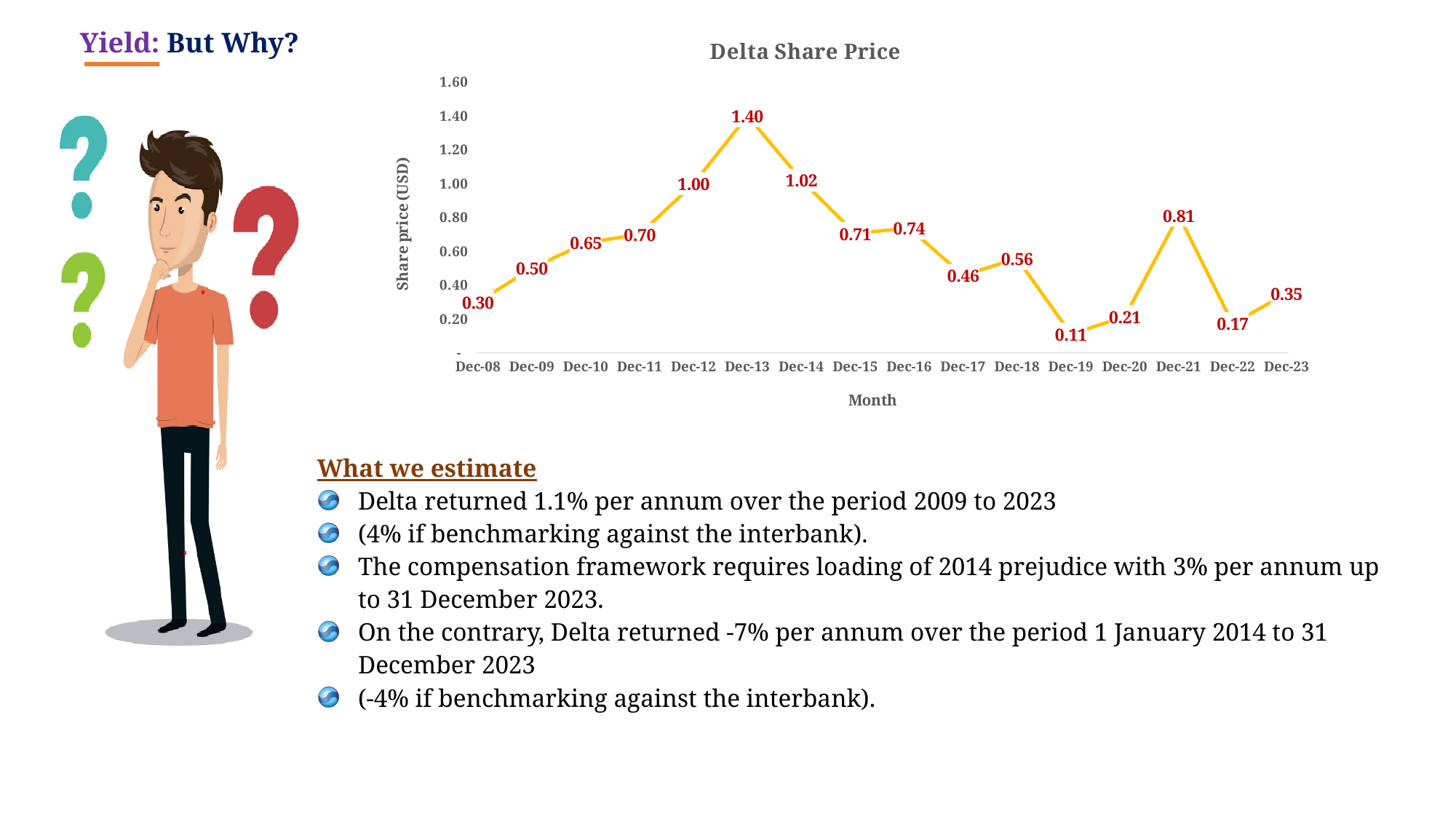
What kind of chart is shown? line chart What is the difference between the share price at Dec-13 and at Dec-14? 0.38 At which month is the Delta share price highest? Dec-13 What is the Delta share price at Dec-13? 1.40 Does the share price rise or fall from Dec-08 to Dec-13? rise Which is larger, the share price at Dec-21 or at Dec-16? Dec-21 How many months are plotted on the x axis? 16 What is the Delta share price at Dec-19? 0.11 At which month is the Delta share price lowest? Dec-19 What is the Delta share price at Dec-23? 0.35 Is the share price at Dec-12 greater or less than 0.80? greater What is the title of the chart? Delta Share Price